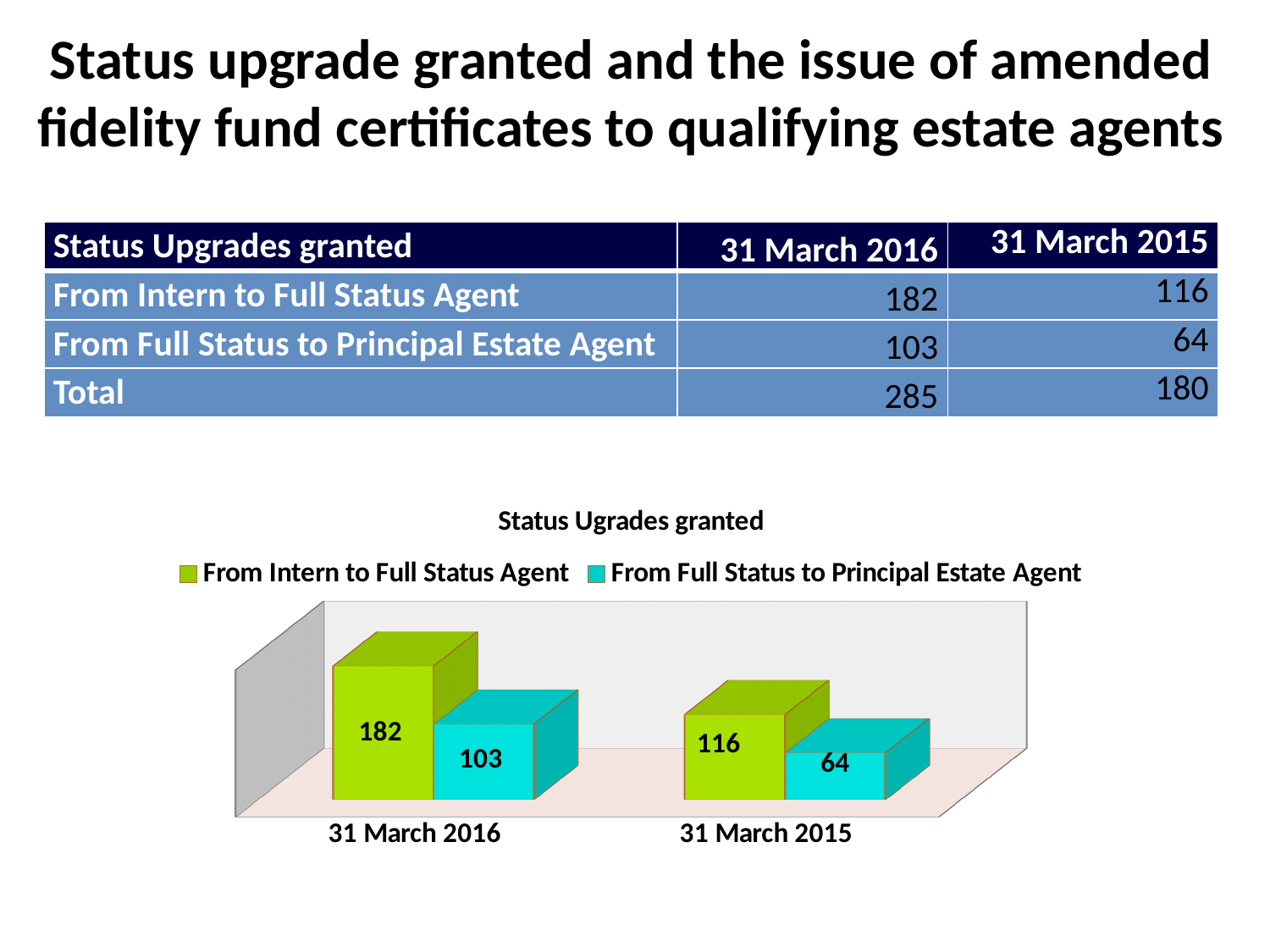
How many series does the chart legend list? 2 What is the value for From Full Status to Principal Estate Agent at 31 March 2015? 64 What is the difference between the From Intern to Full Status Agent values for 31 March 2016 and 31 March 2015? 66 What is the value for From Full Status to Principal Estate Agent at 31 March 2016? 103 Which is larger: From Intern to Full Status Agent at 31 March 2015 or From Full Status to Principal Estate Agent at 31 March 2016? From Intern to Full Status Agent at 31 March 2015 Which category has the highest value for From Intern to Full Status Agent? 31 March 2016 How many categories are shown on the x axis of the chart? 2 What kind of chart is shown on the slide? Bar chart What is the value for From Intern to Full Status Agent at 31 March 2015? 116 What is the value for From Intern to Full Status Agent at 31 March 2016? 182 What is the difference between the two series values at 31 March 2016? 79 Which category has the lowest value for From Full Status to Principal Estate Agent? 31 March 2015